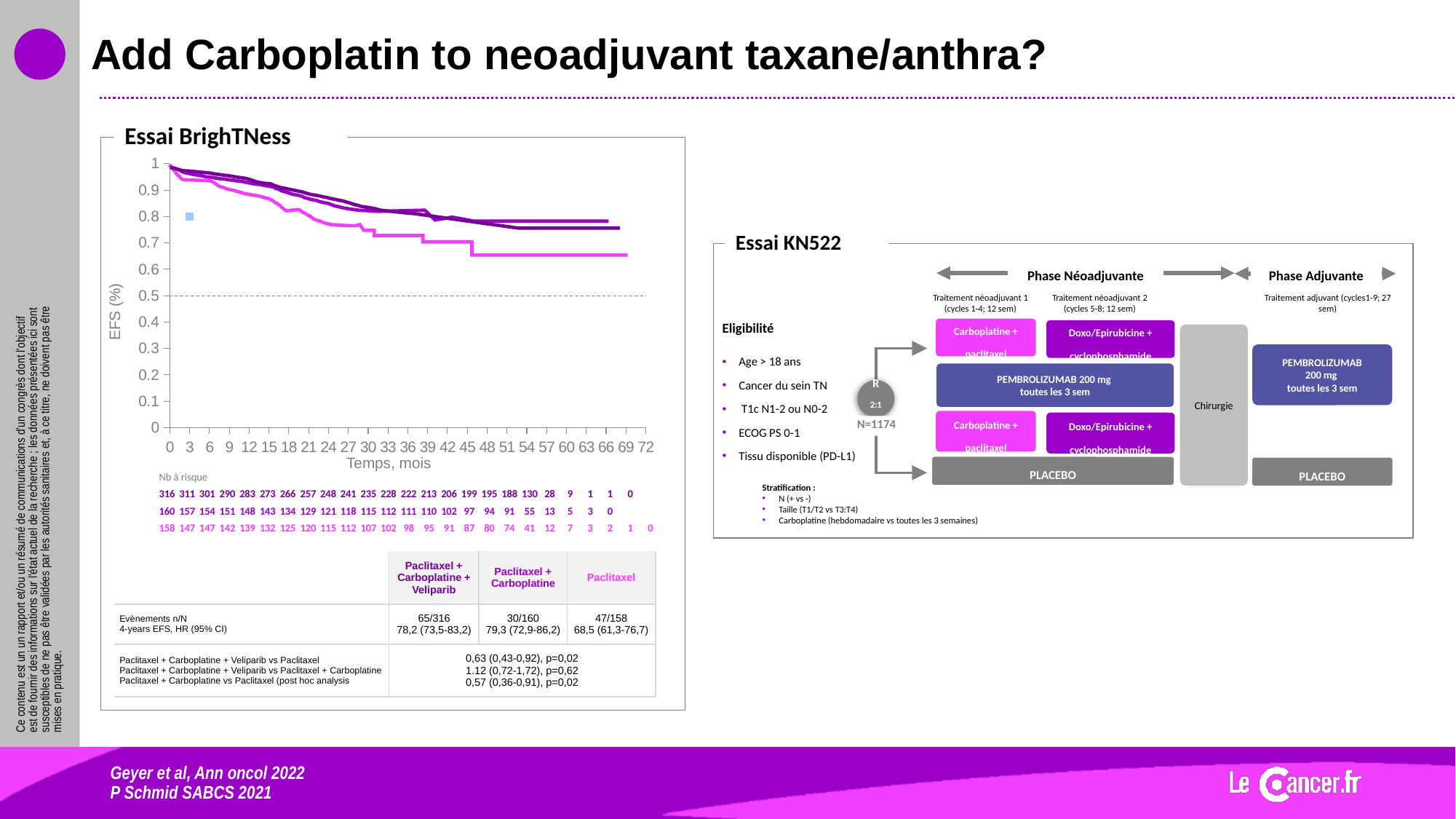
What kind of chart is shown in the Essai BrighTNess panel? line chart In the Essai BrighTNess chart, at 60 months is the Paclitaxel (pink) curve greater or less than 0.7? less In the Essai BrighTNess chart, do the EFS curves rise or fall as time increases? fall In the Essai BrighTNess chart, at 60 months is the Paclitaxel + Carboplatine + Veliparib (dark purple) curve greater or less than 0.7? greater How many survival curves are plotted in the Essai BrighTNess chart? 3 In the Essai BrighTNess chart, what is the label of the x axis? Temps, mois In the Essai BrighTNess chart, which treatment arm has the lowest curve at the end of follow-up? Paclitaxel In the Essai BrighTNess number-at-risk table, how many Paclitaxel patients were at risk at 24 months? 115 In the Essai BrighTNess chart, what is the label of the y axis? EFS (%) In the Essai BrighTNess number-at-risk table, how many patients were at risk at time 0 in the Paclitaxel + Carboplatine + Veliparib arm? 316 In the Essai BrighTNess number-at-risk table, what is the difference between the number at risk at time 0 in the Paclitaxel + Carboplatine + Veliparib arm and in the Paclitaxel arm? 158 In the Essai BrighTNess table, what is the 4-year EFS for the Paclitaxel + Carboplatine arm? 79,3 (72,9-86,2)